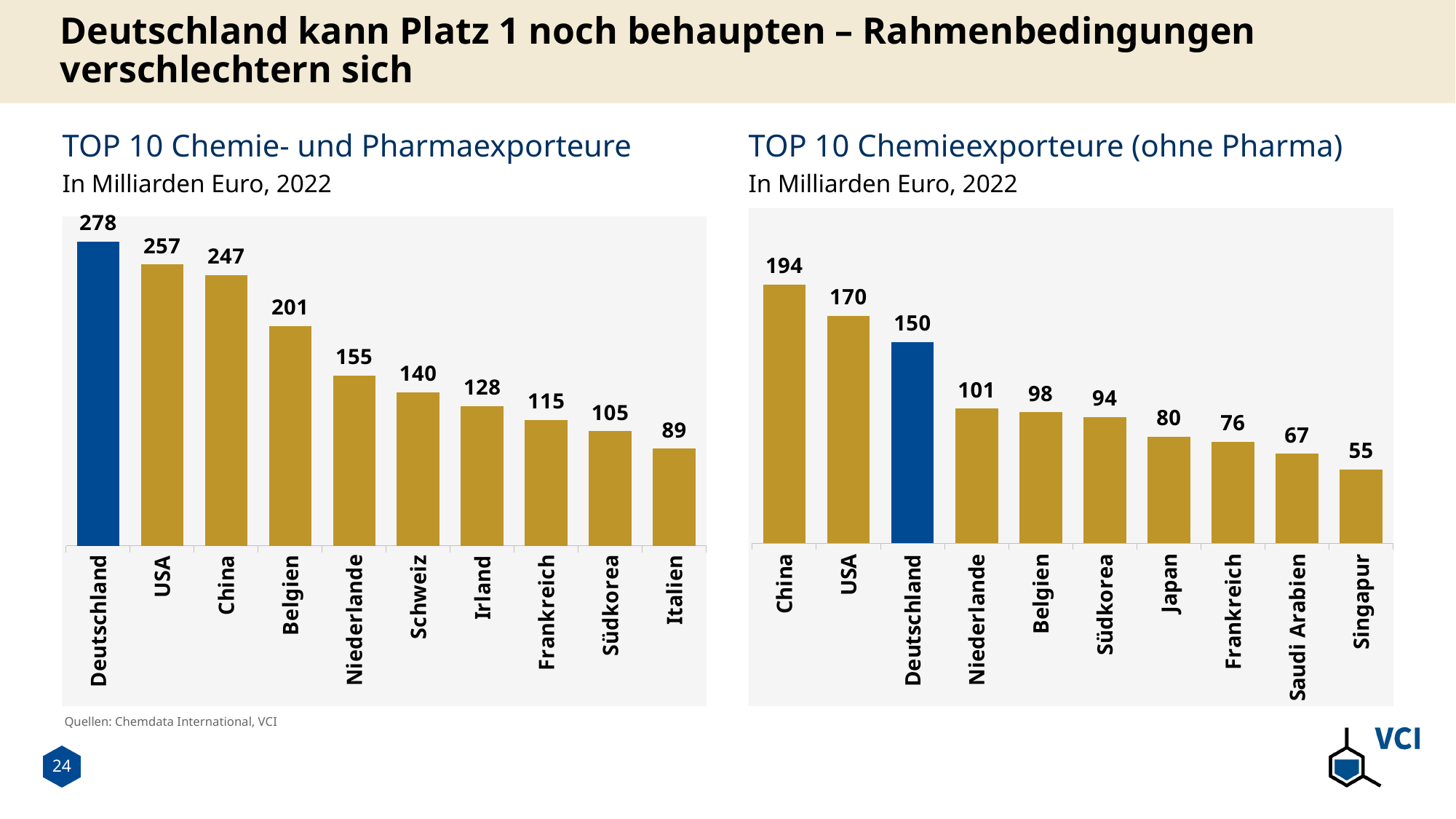
In the chart 'TOP 10 Chemieexporteure (ohne Pharma)', what is the value for Deutschland? 150 In the chart 'TOP 10 Chemieexporteure (ohne Pharma)', what is the difference between the values for China and USA? 24 In the chart 'TOP 10 Chemie- und Pharmaexporteure', which country has the lowest value? Italien In the chart 'TOP 10 Chemie- und Pharmaexporteure', how many countries are shown? 10 In the chart 'TOP 10 Chemie- und Pharmaexporteure', what is the difference between the values for USA and China? 10 In the chart 'TOP 10 Chemieexporteure (ohne Pharma)', which country has the highest value? China In the chart 'TOP 10 Chemieexporteure (ohne Pharma)', which is larger, the value for Japan or the value for Frankreich? Japan In the chart 'TOP 10 Chemie- und Pharmaexporteure', do the values rise or fall from left to right? Fall What kind of chart is 'TOP 10 Chemieexporteure (ohne Pharma)'? Bar chart In the chart 'TOP 10 Chemie- und Pharmaexporteure', what is the value for Belgien? 201 In the chart 'TOP 10 Chemie- und Pharmaexporteure', what is the value for Deutschland? 278 In the chart 'TOP 10 Chemieexporteure (ohne Pharma)', what is the value for China? 194